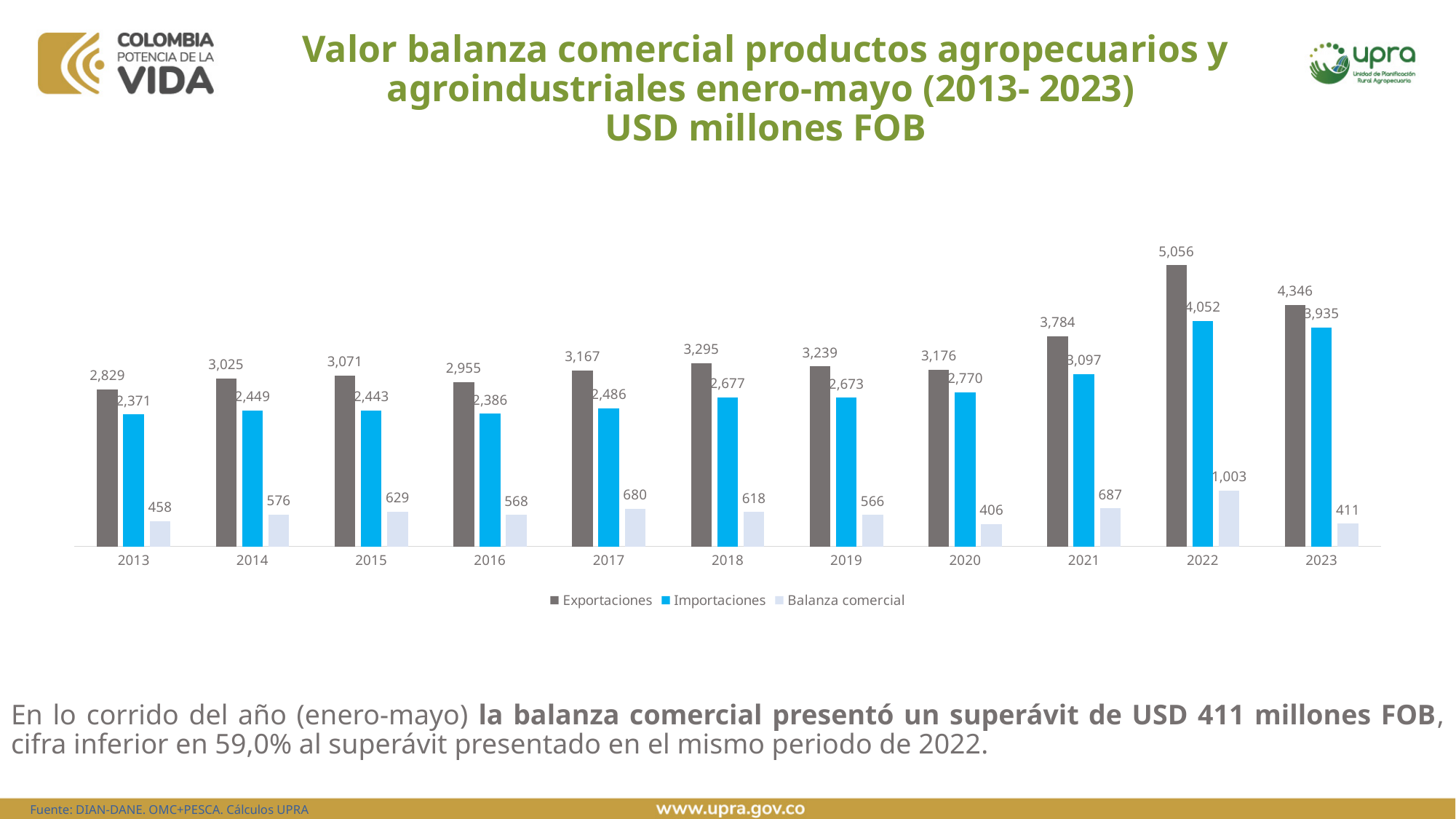
What is the difference between Exportaciones and Importaciones in 2023? 411 What is the value of Importaciones in 2013? 2,371 How many series does the legend list? 3 Which is larger, Balanza comercial in 2017 or in 2021? 2021 Did Importaciones rise or fall from 2021 to 2022? Rise Which year has the lowest Balanza comercial value? 2020 How many years are shown on the x axis? 11 What is the value of Exportaciones in 2022? 5,056 What is the value of Balanza comercial in 2023? 411 What kind of chart is shown on the slide? Bar chart Which year has the highest Exportaciones value? 2022